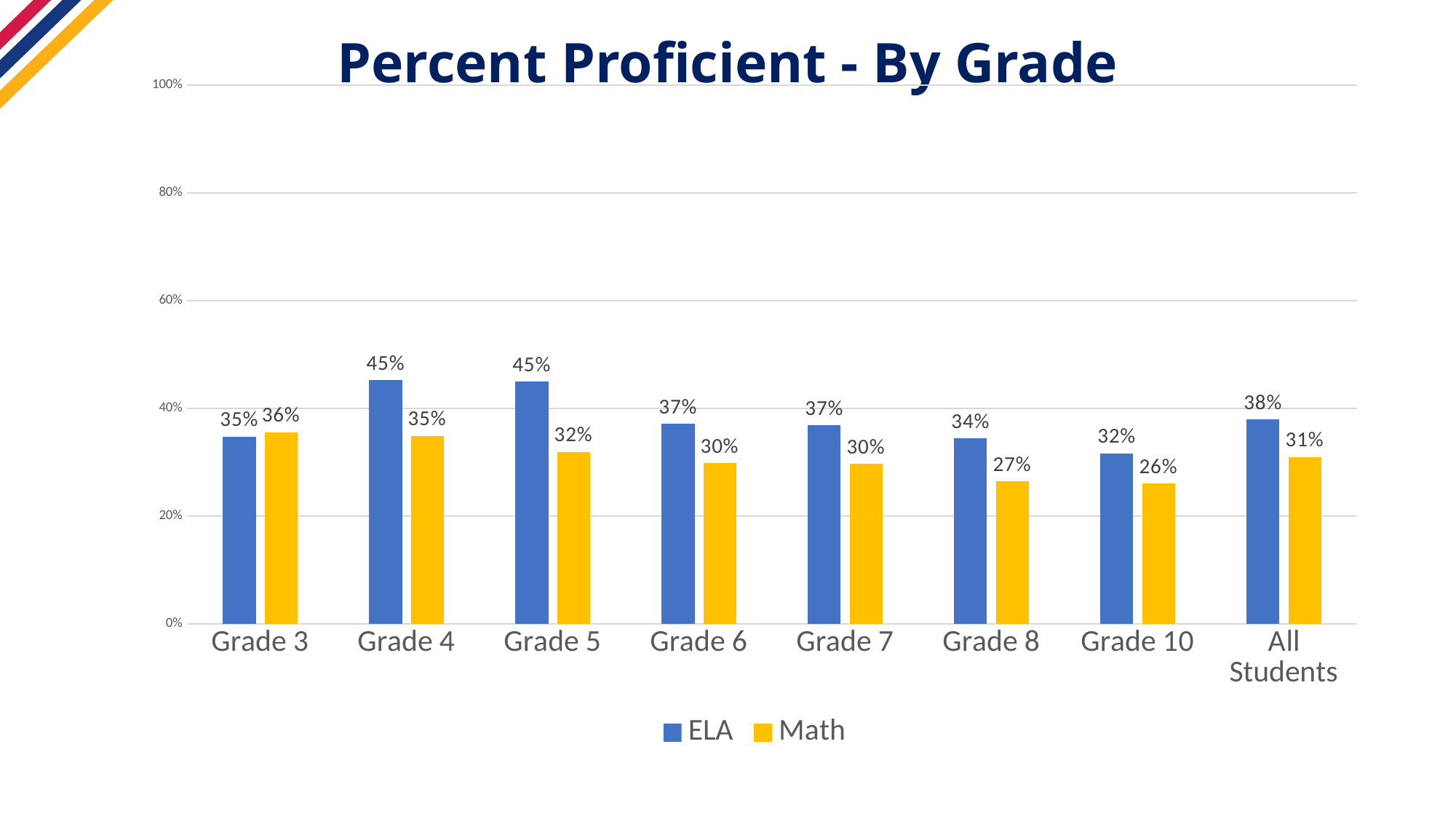
What is the Math value for Grade 10? 26% Which category has the lowest ELA value? Grade 10 Which is larger for Grade 3, the ELA value or the Math value? Math What is the ELA value for All Students? 38% Is the ELA value for Grade 4 greater or less than 40%? greater Which category has the lowest Math value? Grade 10 How many series does the legend list? 2 What is the title of the chart? Percent Proficient - By Grade What is the difference between the ELA and Math values for Grade 5? 13% What kind of chart is shown on the slide? bar chart What is the ELA value for Grade 4? 45% How many categories are shown on the x axis? 8